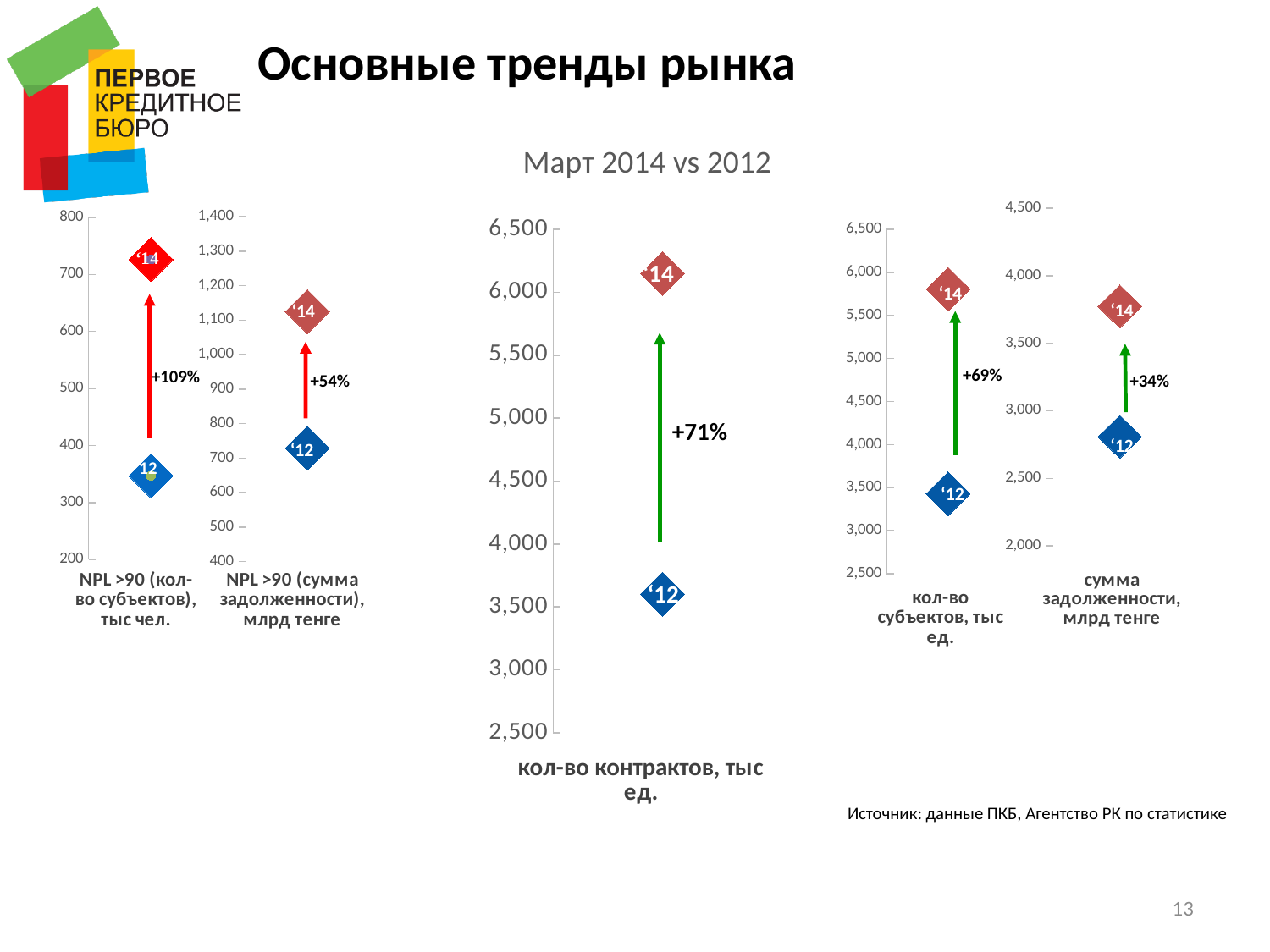
On the chart 'NPL >90 (кол-во субъектов), тыс чел.', what percentage change is labelled between '12 and '14? +109% On the chart 'кол-во контрактов, тыс ед.', is the value for '12 greater or less than 4,000? less On the chart 'кол-во субъектов, тыс ед.', is the value for '14 greater or less than 5,000? greater On the chart 'кол-во субъектов, тыс ед.', what percentage change is labelled between '12 and '14? +69% On the chart 'сумма задолженности, млрд тенге' (rightmost chart), what percentage change is labelled between '12 and '14? +34% On the chart 'NPL >90 (сумма задолженности), млрд тенге', is the value for '14 greater or less than 1,000? greater On the chart 'NPL >90 (сумма задолженности), млрд тенге', what percentage change is labelled between '12 and '14? +54% How many data points are plotted on the chart 'кол-во контрактов, тыс ед.'? 2 On the chart 'кол-во контрактов, тыс ед.', what percentage change is labelled between '12 and '14? +71% On the chart 'сумма задолженности, млрд тенге' (rightmost chart), which point is higher, '12 or '14? '14 What is the subtitle shown above the charts on the slide? Март 2014 vs 2012